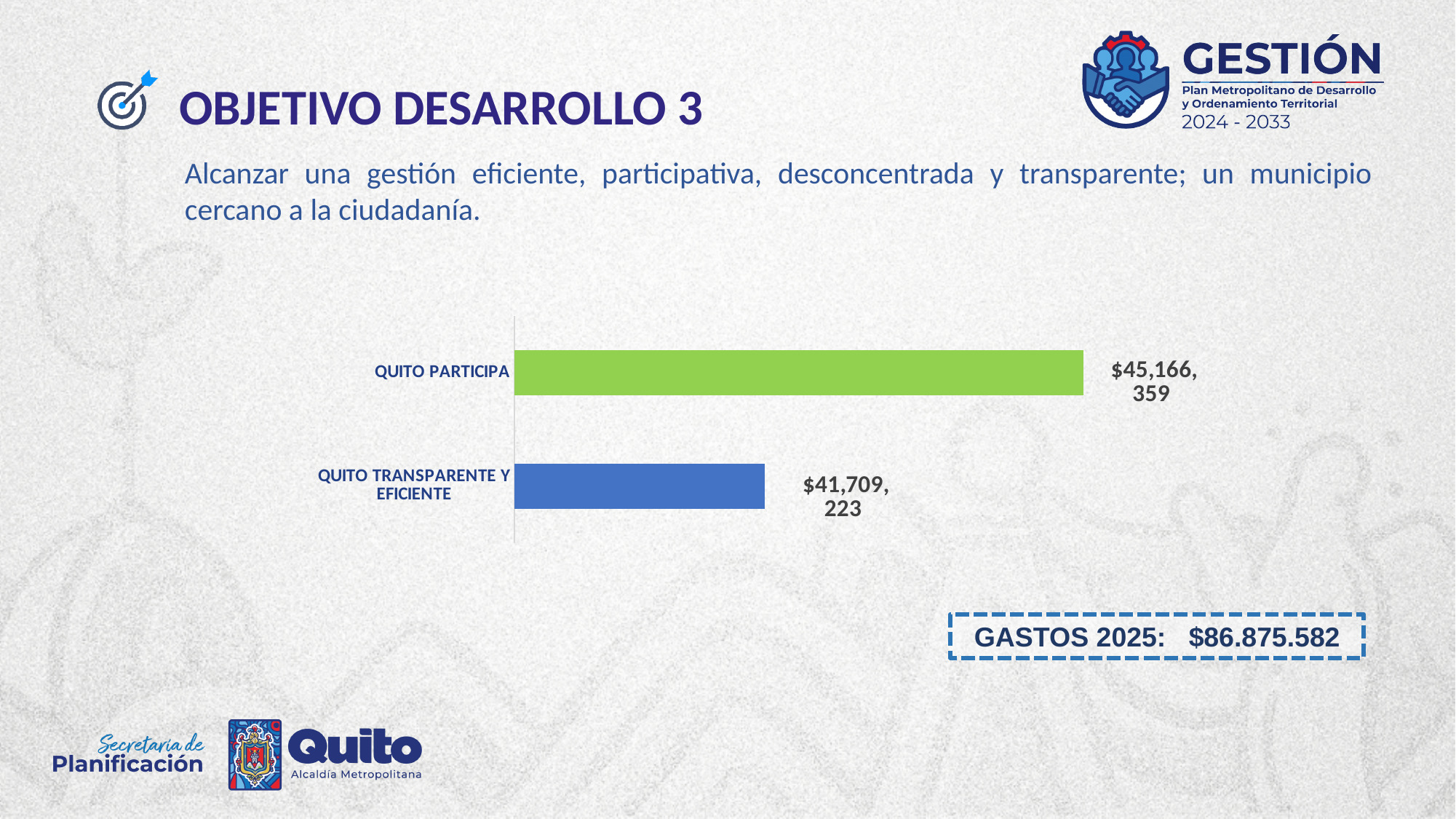
What colour is the bar for QUITO PARTICIPA? Green Which category has the lowest value? QUITO TRANSPARENTE Y EFICIENTE What colour is the bar for QUITO TRANSPARENTE Y EFICIENTE? Blue What is the sum of the two bar values in the chart? $86,875,582 Which is larger, the value for QUITO PARTICIPA or the value for QUITO TRANSPARENTE Y EFICIENTE? QUITO PARTICIPA What is the value for QUITO TRANSPARENTE Y EFICIENTE? $41,709,223 What is the difference between the values for QUITO PARTICIPA and QUITO TRANSPARENTE Y EFICIENTE? $3,457,136 Which category has the highest value? QUITO PARTICIPA What is the value for QUITO PARTICIPA? $45,166,359 What kind of chart is shown on the slide? Bar chart How many categories are shown in the chart? 2